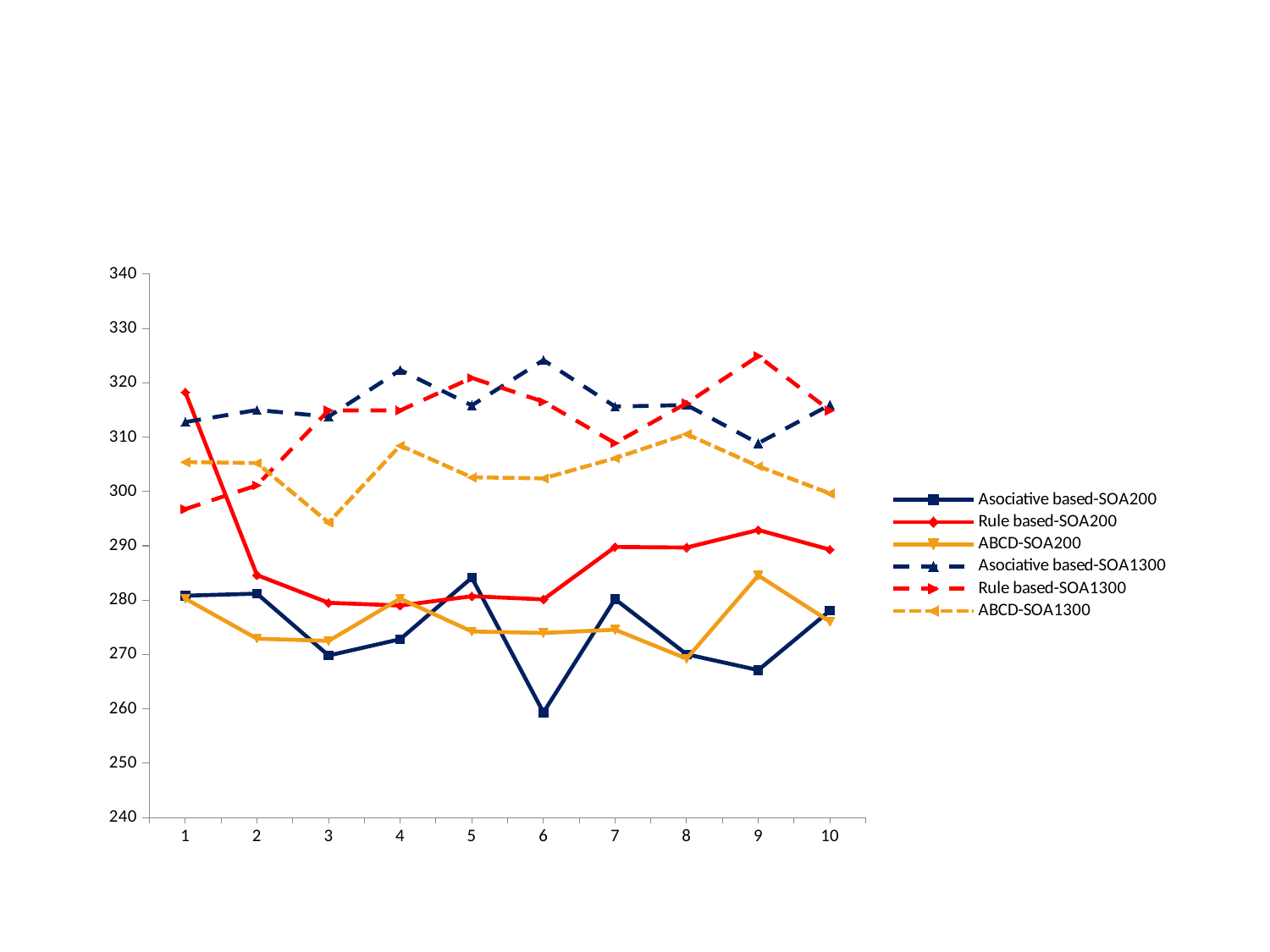
How many points are there along the x axis? 10 Does the Rule based-SOA200 series rise or fall from x = 1 to x = 2? fall At which x value does the Rule based-SOA1300 series reach its highest point? 9 Is the value for Rule based-SOA200 at x = 1 greater or less than 310? greater Is the value for Associative based-SOA200 at x = 6 greater or less than 270? less At which x value does the Associative based-SOA200 series reach its lowest point? 6 Is the value for Rule based-SOA1300 at x = 9 greater or less than 320? greater What kind of chart is shown on the slide? line chart At x = 1, which is larger: Rule based-SOA200 or Associative based-SOA200? Rule based-SOA200 How many series does the legend list? 6 At which x value does the Rule based-SOA200 series reach its highest point? 1